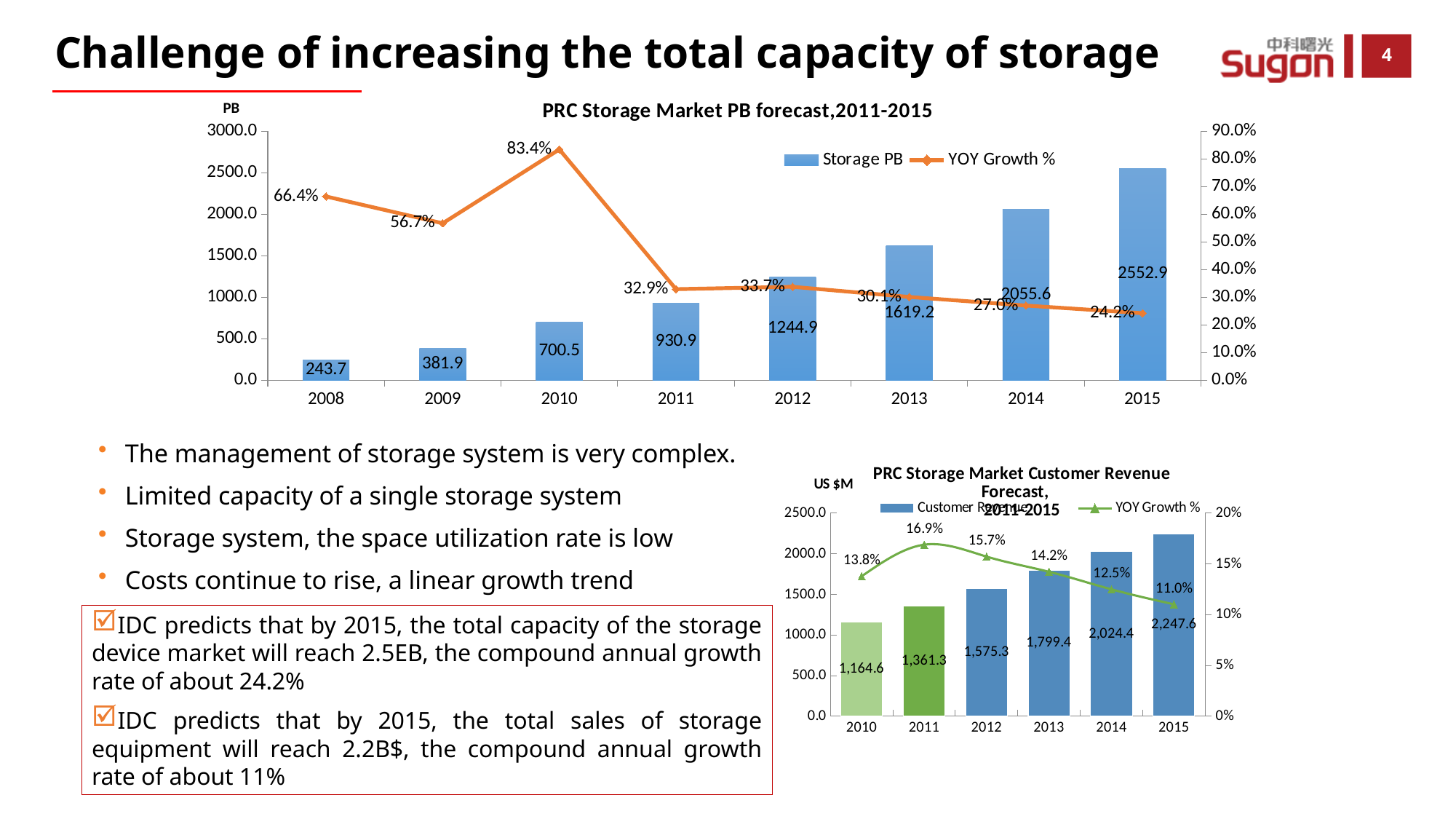
In the 'PRC Storage Market Customer Revenue Forecast' chart, which year has the highest YOY Growth %? 2011 In the 'PRC Storage Market PB forecast,2011-2015' chart, what is the difference in Storage PB between 2015 and 2014? 497.3 In the 'PRC Storage Market PB forecast,2011-2015' chart, which year has the lowest YOY Growth %? 2015 In the 'PRC Storage Market Customer Revenue Forecast' chart, what is the YOY Growth % for 2011? 16.9% In the 'PRC Storage Market PB forecast,2011-2015' chart, how many years are shown on the x axis? 8 In the 'PRC Storage Market Customer Revenue Forecast' chart, do the Customer Revenue values rise or fall from 2010 to 2015? rise In the 'PRC Storage Market PB forecast,2011-2015' chart, how many series does the legend list? 2 In the 'PRC Storage Market PB forecast,2011-2015' chart, which year has the highest Storage PB value? 2015 In the 'PRC Storage Market PB forecast,2011-2015' chart, what is the YOY Growth % for 2010? 83.4% In the 'PRC Storage Market Customer Revenue Forecast' chart, is the Customer Revenue for 2014 larger or smaller than for 2012? larger In the 'PRC Storage Market Customer Revenue Forecast' chart, what is the Customer Revenue for 2013? 1,799.4 In the 'PRC Storage Market PB forecast,2011-2015' chart, what is the Storage PB value for 2012? 1244.9